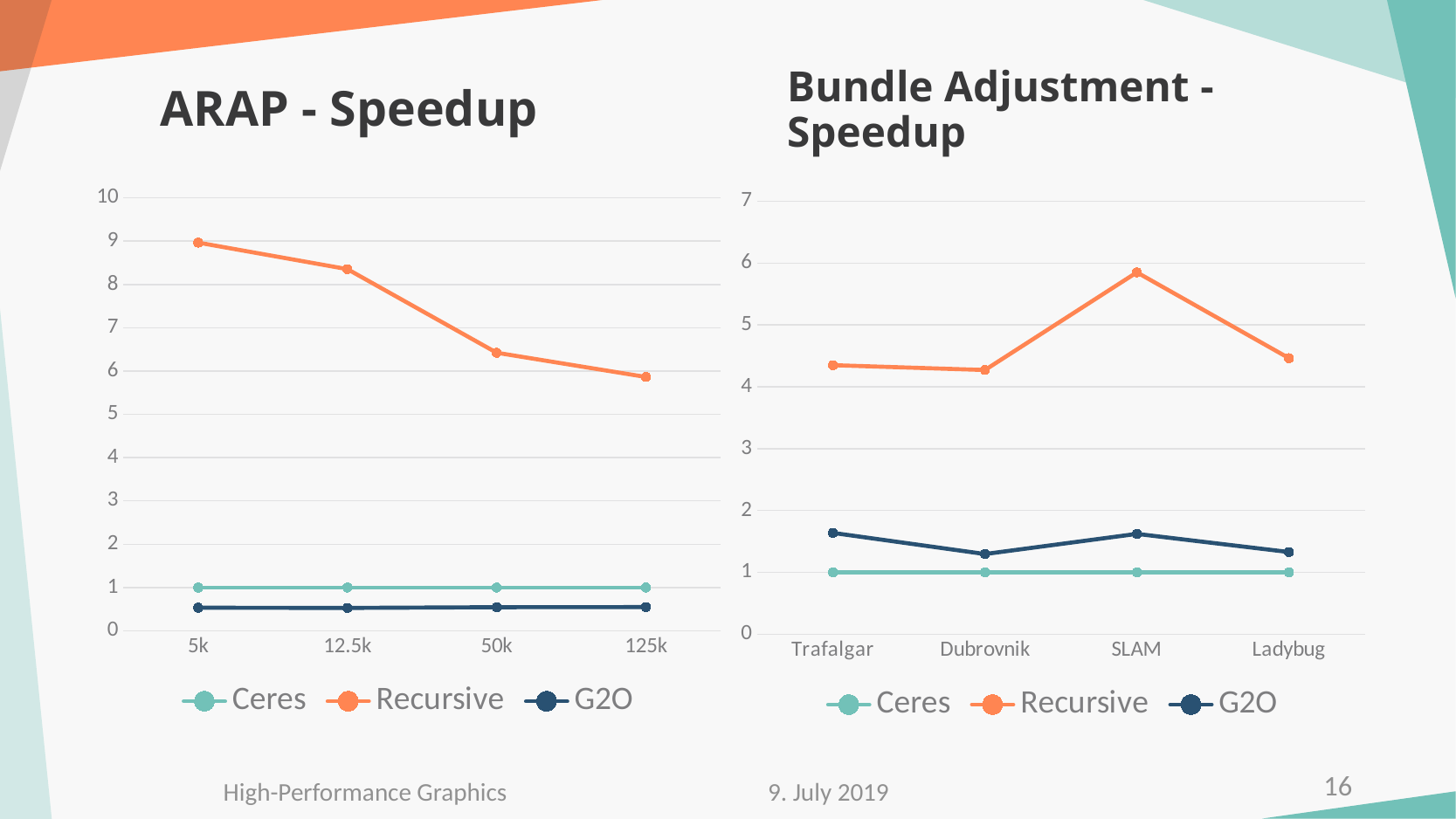
In the Bundle Adjustment - Speedup chart, which category has the highest Recursive value? SLAM In the ARAP - Speedup chart, is the G2O value at 50k greater or less than 1? less In the Bundle Adjustment - Speedup chart, is the Recursive value for SLAM greater or less than 5? greater In the ARAP - Speedup chart, does the Recursive series rise or fall from 5k to 125k? fall In the ARAP - Speedup chart, how many categories are on the x axis? 4 In the Bundle Adjustment - Speedup chart, which is larger, the G2O value for Trafalgar or the G2O value for Dubrovnik? Trafalgar In the Bundle Adjustment - Speedup chart, which series is drawn in orange? Recursive In the ARAP - Speedup chart, how many series does the legend list? 3 In the ARAP - Speedup chart, what kind of chart is shown? line chart In the ARAP - Speedup chart, which series has the highest values? Recursive In the ARAP - Speedup chart, what is the Ceres value at 12.5k? 1 In the ARAP - Speedup chart, is the Recursive value at 5k greater or less than 8? greater